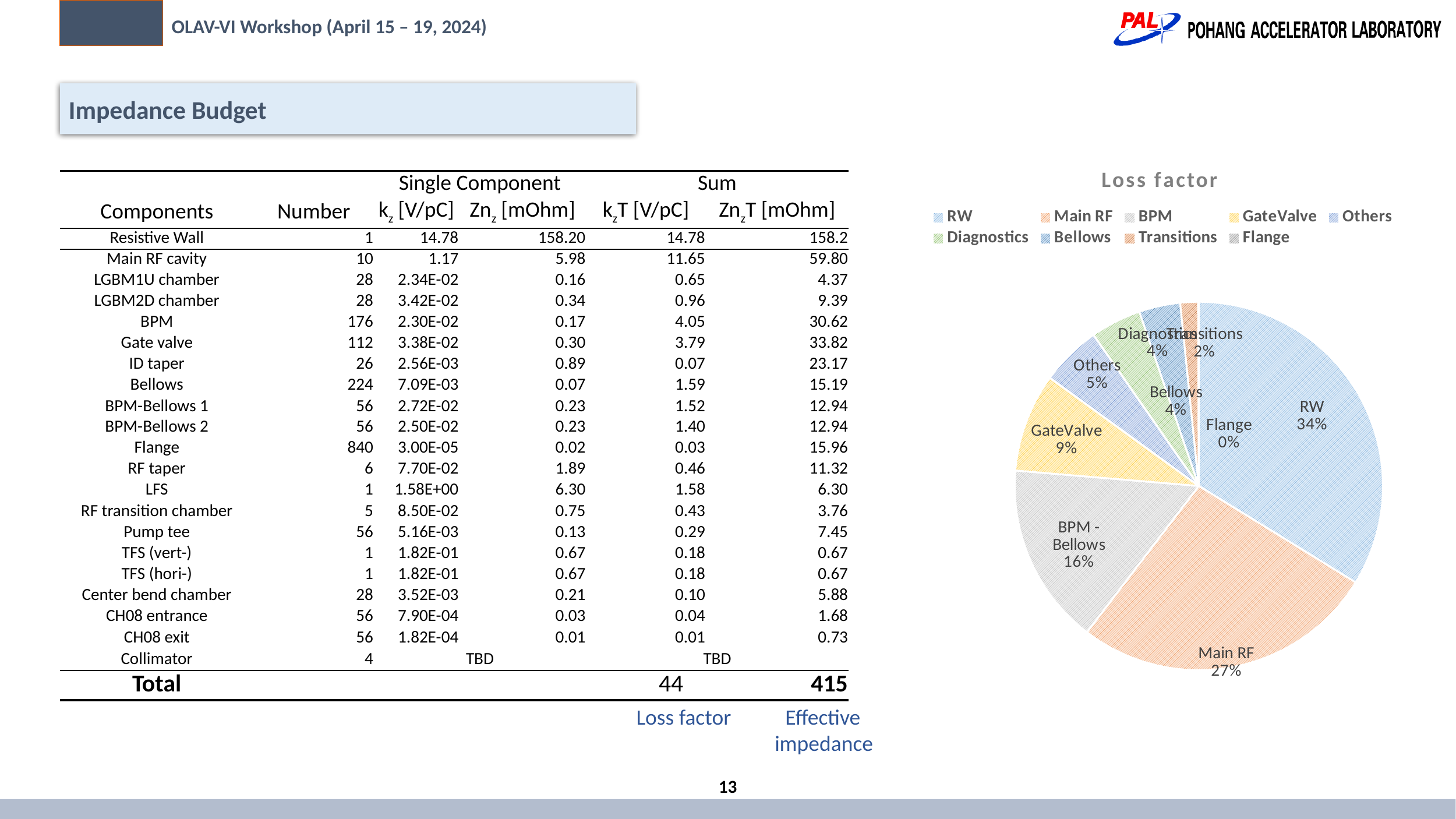
What is the title of the pie chart on the slide? Loss factor In the "Loss factor" pie chart, what share does Main RF have? 27% What kind of chart is the "Loss factor" chart? pie chart In the "Loss factor" pie chart, which is larger: GateValve or Others? GateValve Which slice is the largest in the "Loss factor" pie chart? RW In the "Loss factor" pie chart, what share does Others have? 5% In the "Loss factor" pie chart, how many percentage points larger is RW than Main RF? 7 In the "Loss factor" pie chart, what share does Transitions have? 2% In the "Loss factor" pie chart, what share does RW have? 34% Which slice is the smallest in the "Loss factor" pie chart? Flange In the "Loss factor" pie chart, what share does GateValve have? 9% How many entries does the legend of the "Loss factor" pie chart list? 9